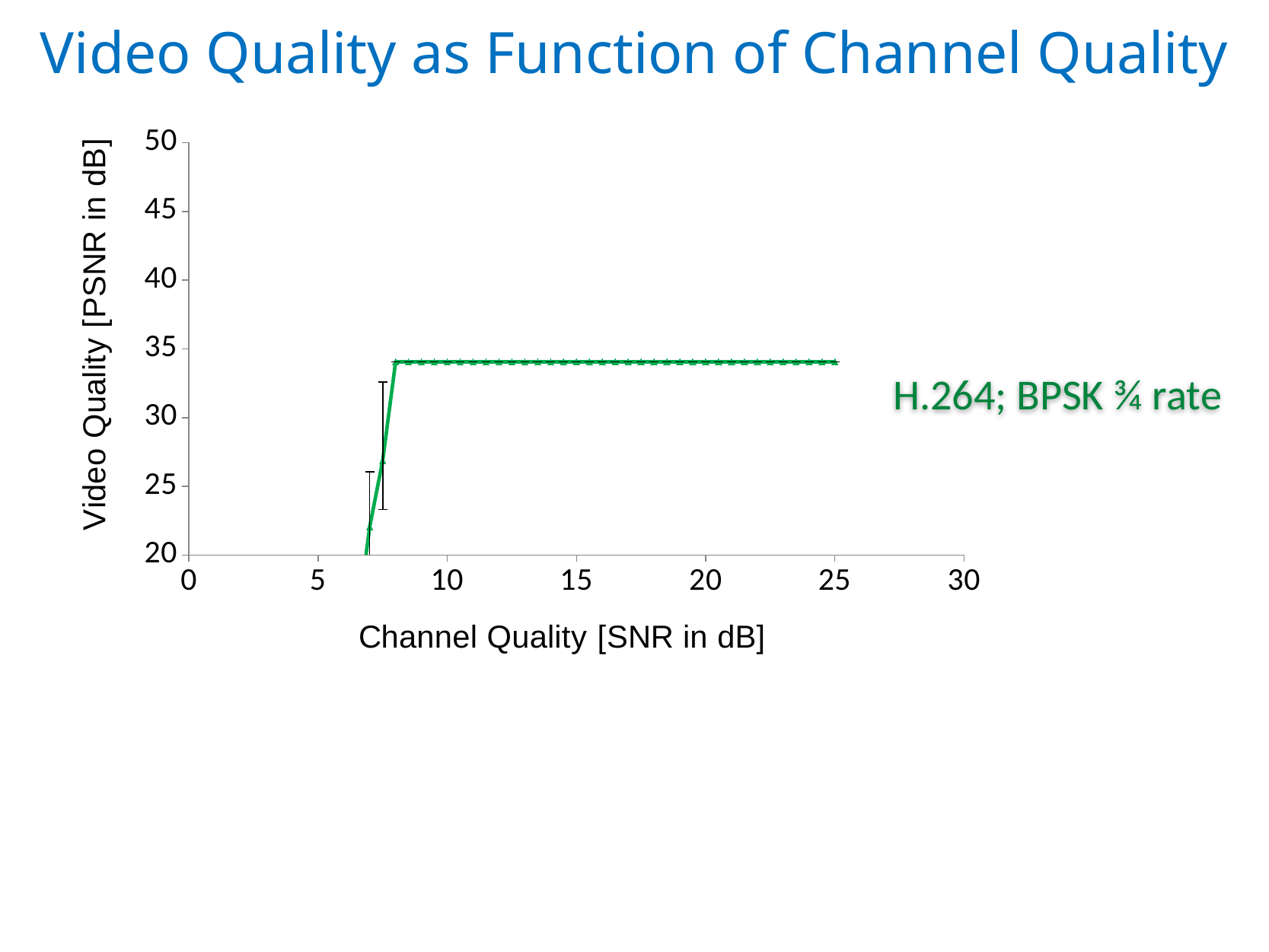
What is the highest value shown on the y axis? 50 Is the video quality at a channel quality of 25 dB greater or less than 40? less Is the video quality at a channel quality of 15 dB greater or less than 30? greater Is the video quality at a channel quality of 10 dB greater or less than 25? greater How does video quality change as channel quality increases from 7 dB to 10 dB? it rises What is the title of the chart? Video Quality as Function of Channel Quality What kind of chart is shown on the slide? line chart What label is given to the plotted series? H.264; BPSK ¾ rate How does video quality change as channel quality increases from 10 dB to 25 dB? it stays flat